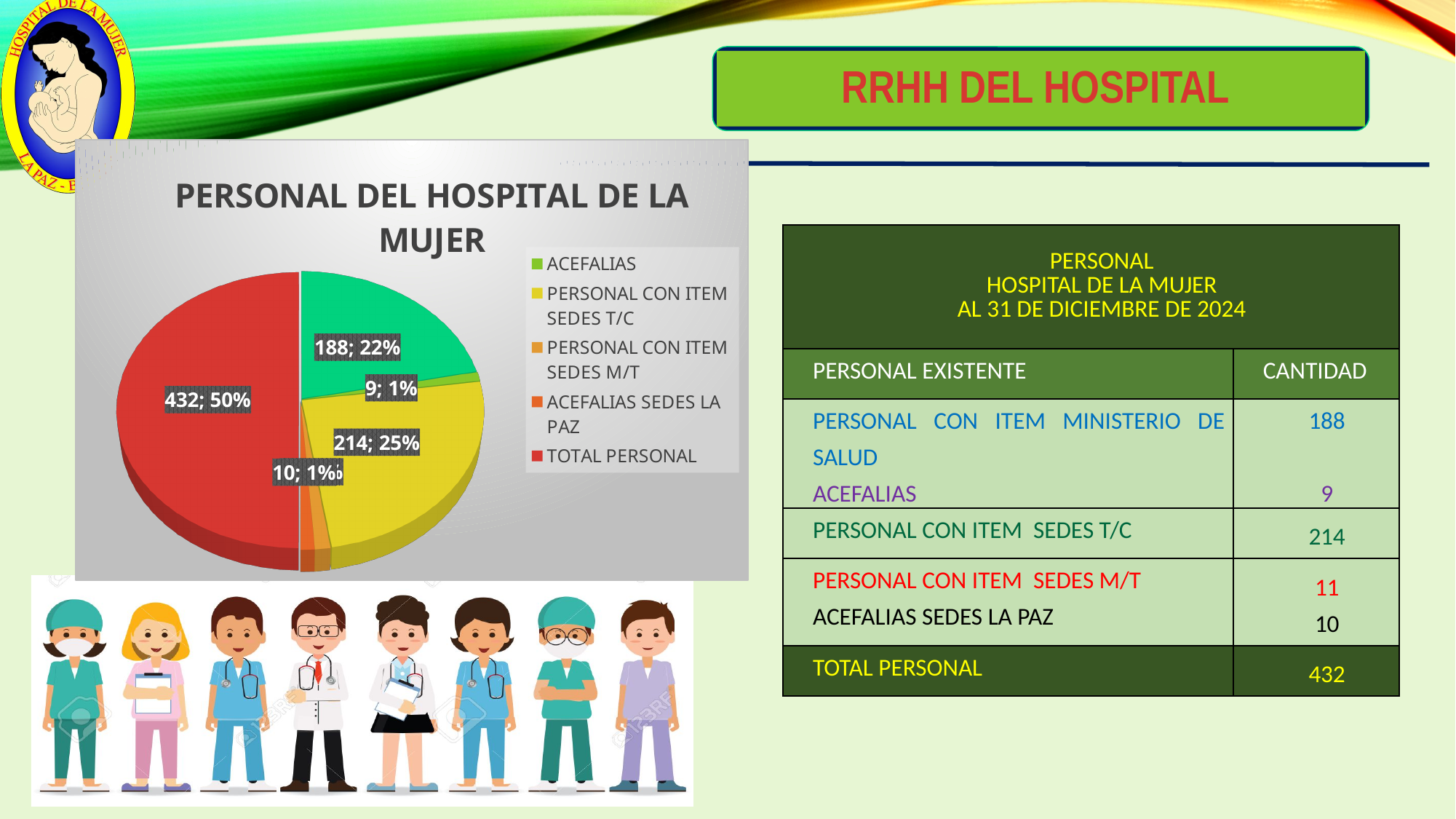
What percentage is shown for the slice labelled 214 in the pie chart? 25% What share of the pie does the largest slice (432) represent? 50% What is the difference between the slice labelled 432 and the slice labelled 214 in the pie chart? 218 What is the value shown on the largest slice of the pie chart? 432 What value is shown for PERSONAL CON ITEM SEDES T/C in the pie chart? 214 What kind of chart is shown on the slide? pie chart What is the title of the pie chart? PERSONAL DEL HOSPITAL DE LA MUJER What is the smallest value printed on a data label in the pie chart? 9 What percentage is shown on the green slice of the pie chart? 22% How many entries does the legend of the pie chart list? 5 Which slice is larger in the pie chart, the one labelled 188 or the one labelled 214? 214 What value is shown on the green slice of the pie chart? 188